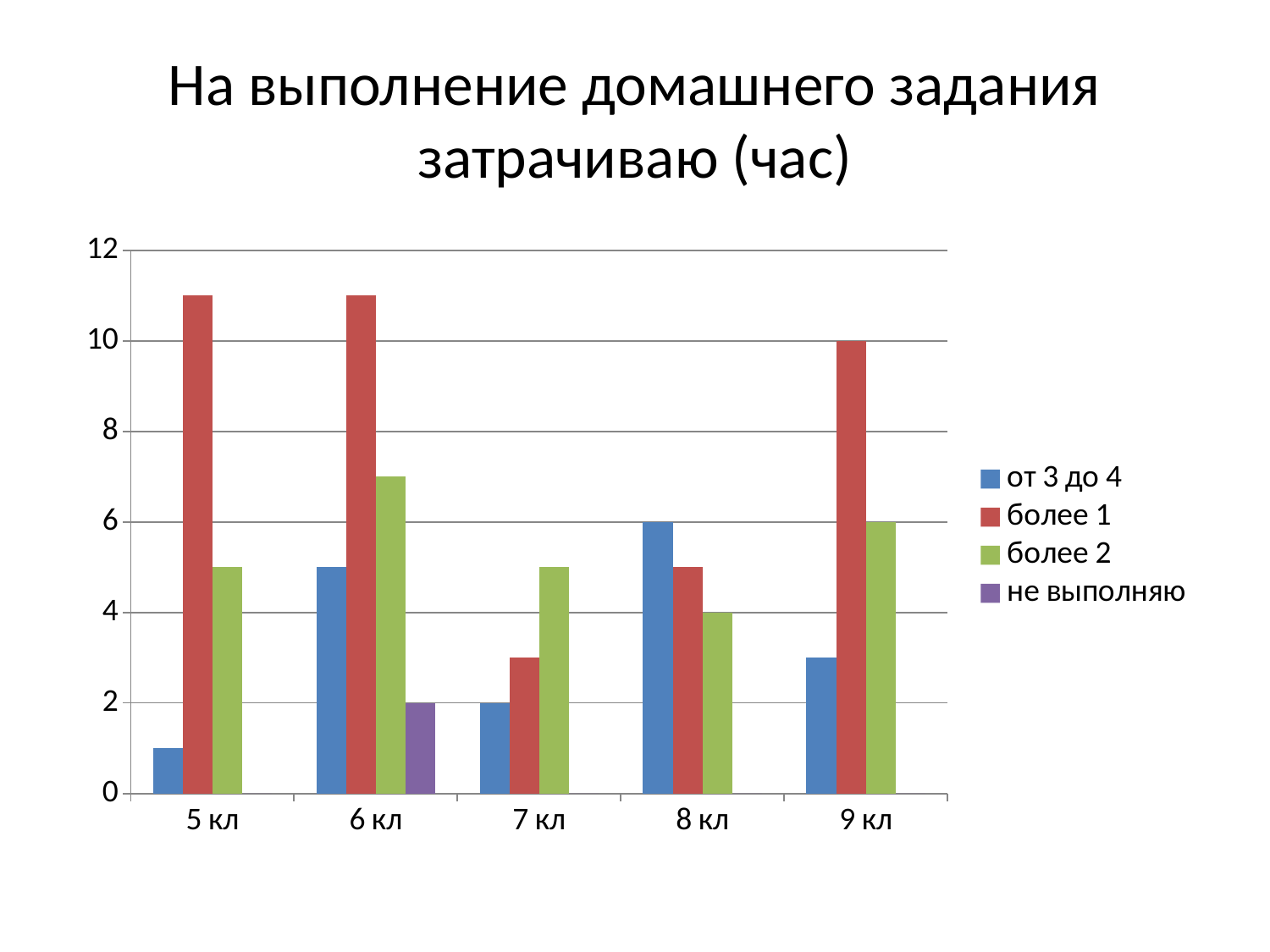
How many class categories are shown on the x axis? 5 Is the value for "более 1" in 5 кл greater or less than 10? greater What is the value for "более 1" in 9 кл? 10 How many series does the legend list? 4 What is the difference between "более 1" and "более 2" in 9 кл? 4 What is the value for "не выполняю" in 6 кл? 2 What is the value for "от 3 до 4" in 8 кл? 6 Is the value for "от 3 до 4" in 5 кл greater or less than 2? less What type of chart is shown on the slide? bar chart What is the value for "более 2" in 8 кл? 4 Which series has the highest value in 9 кл? более 1